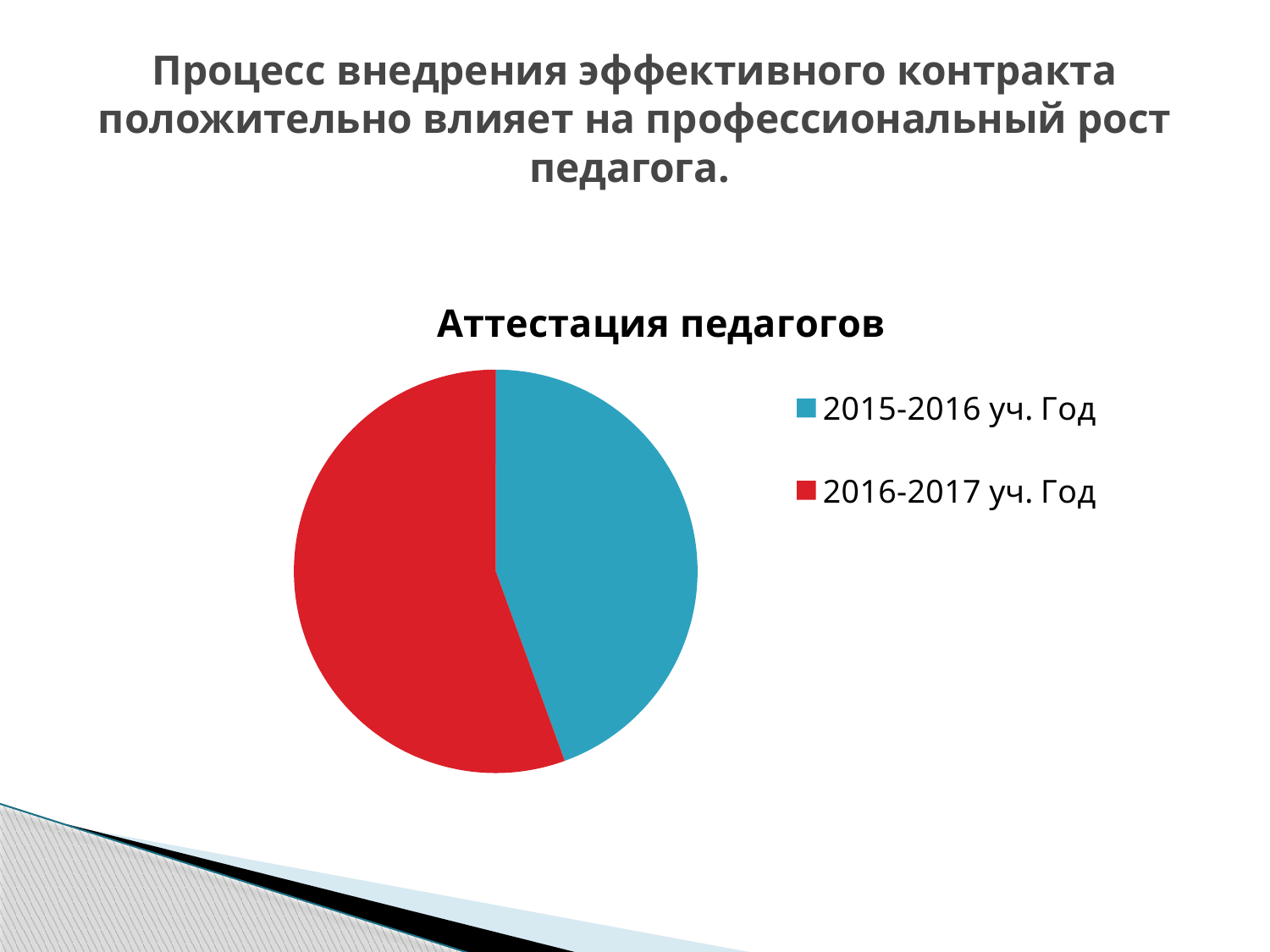
What colour represents 2016-2017 уч. Год in the pie chart? red Which slice is larger, 2015-2016 уч. Год or 2016-2017 уч. Год? 2016-2017 уч. Год What is the title of the chart? Аттестация педагогов Which category has the largest slice of the pie? 2016-2017 уч. Год How many slices does the pie chart have? 2 How many entries does the legend list? 2 Which category has the smallest slice of the pie? 2015-2016 уч. Год What kind of chart is shown on the slide? pie chart Does the slice for 2016-2017 уч. Год take up more or less than half of the pie? more